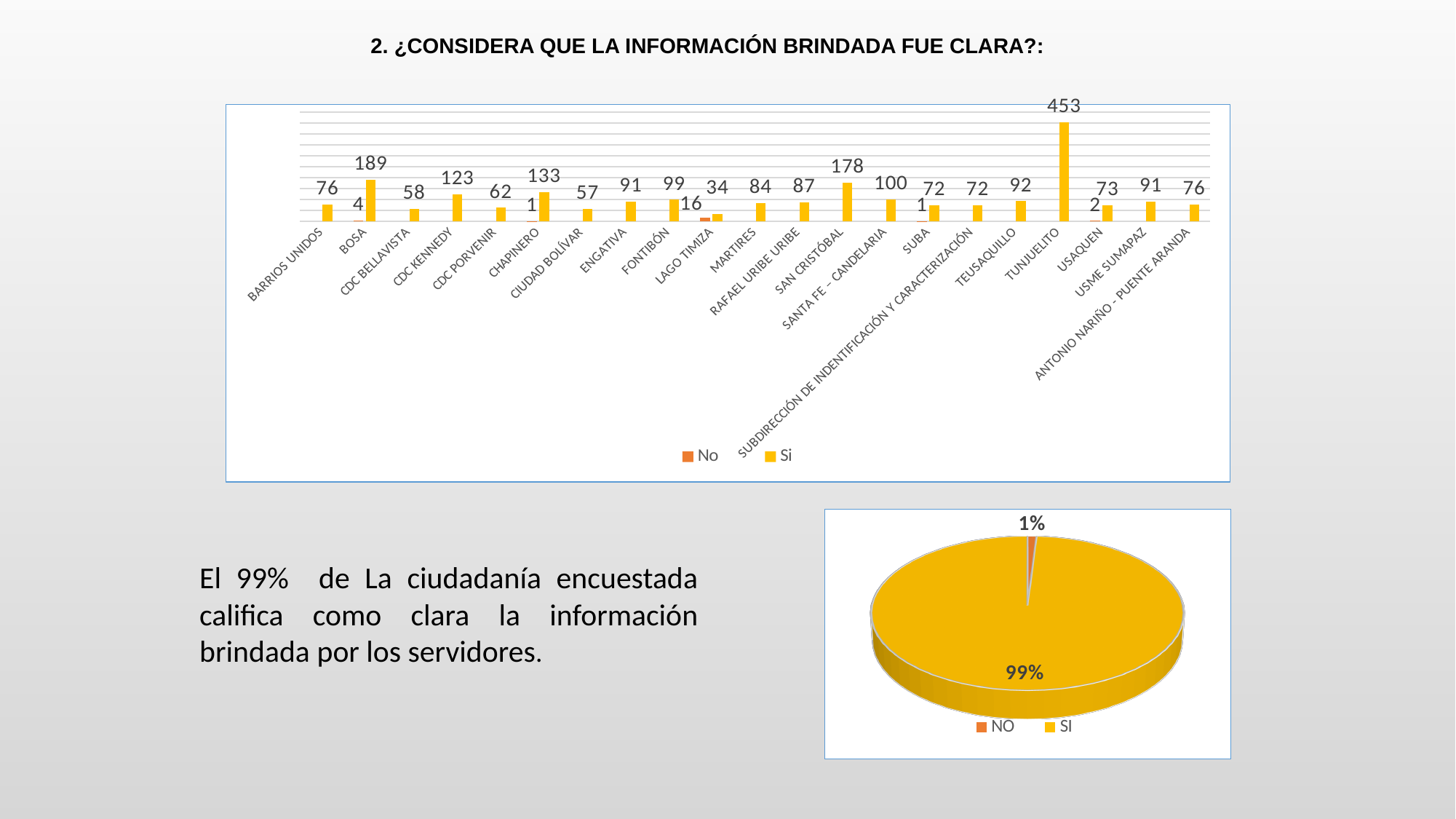
In the bar chart at the top of the slide, which has a larger 'Si' value, CHAPINERO or SANTA FE – CANDELARIA? CHAPINERO In the pie chart at the bottom right of the slide, what colour is the 'NO' slice? Orange How many series does the legend of the bar chart at the top of the slide list? 2 In the pie chart at the bottom right of the slide, what share does the 'SI' slice represent? 99% How many categories are shown on the x axis of the bar chart at the top of the slide? 21 In the bar chart at the top of the slide, which category has the lowest 'Si' value? LAGO TIMIZA In the bar chart at the top of the slide, what is the 'No' value for LAGO TIMIZA? 16 What kind of chart is the chart at the bottom right of the slide? Pie chart In the bar chart at the top of the slide, what is the 'Si' value for SAN CRISTÓBAL? 178 In the bar chart at the top of the slide, which category has the highest 'Si' value? TUNJUELITO In the bar chart at the top of the slide, what is the 'Si' value for TUNJUELITO? 453 In the bar chart at the top of the slide, what is the difference between the 'Si' values for BOSA and CDC KENNEDY? 66